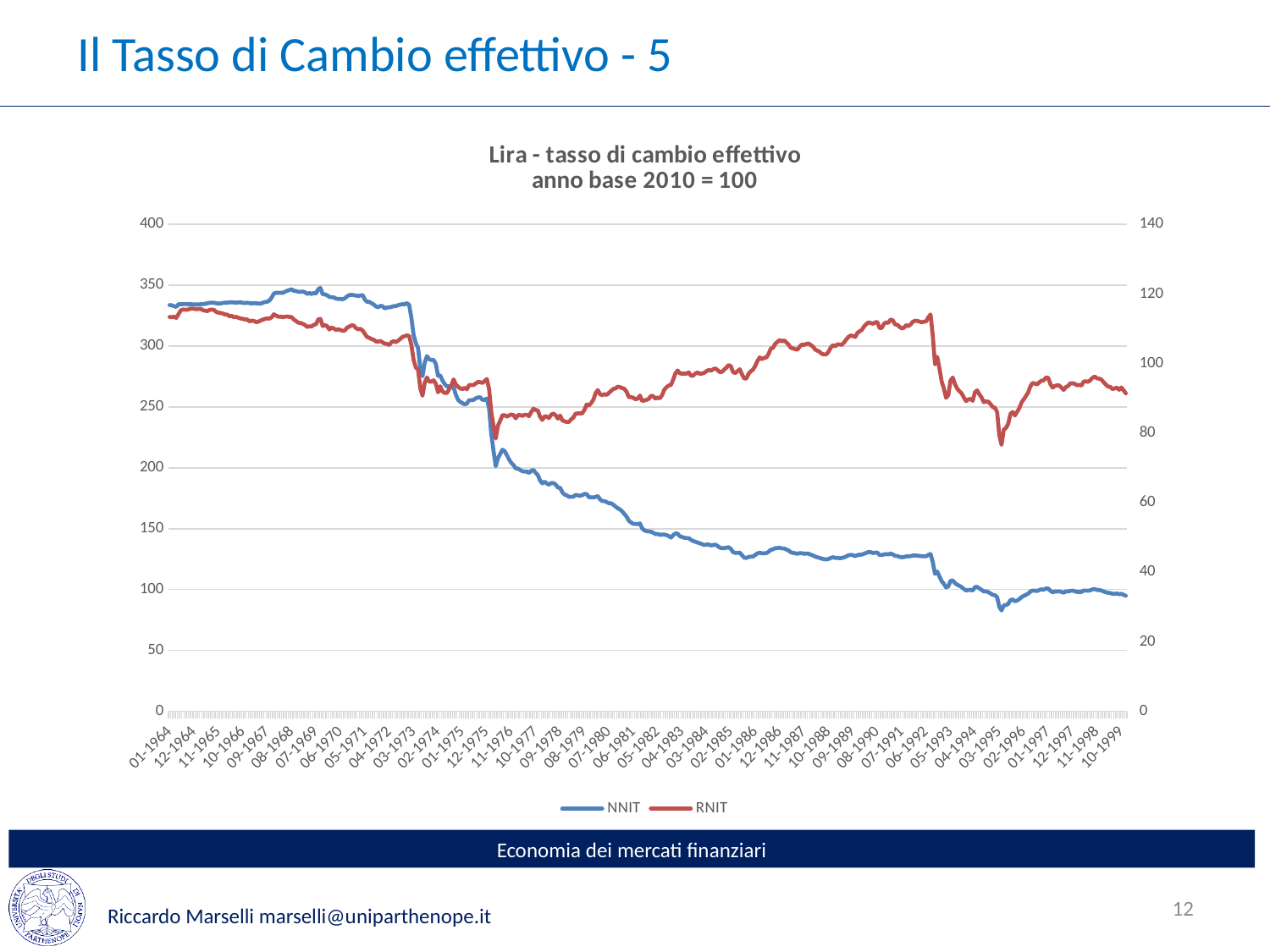
Does the NNIT series overall rise or fall from 01-1964 to 10-1999? fall What are the names of the two series in the legend? NNIT and RNIT How many series does the legend list? 2 Is the RNIT value at 01-1964 greater or less than 100 on the right axis? greater Is the NNIT value around 01-1985 greater or less than 200 on the left axis? less What is the title of the chart? Lira - tasso di cambio effettivo anno base 2010 = 100 Is the NNIT value at 10-1999 greater or less than 150 on the left axis? less Is the NNIT value at 01-1964 larger or smaller than the NNIT value at 10-1999? larger What kind of chart is shown on the slide? line chart What is the maximum value shown on the left vertical axis? 400